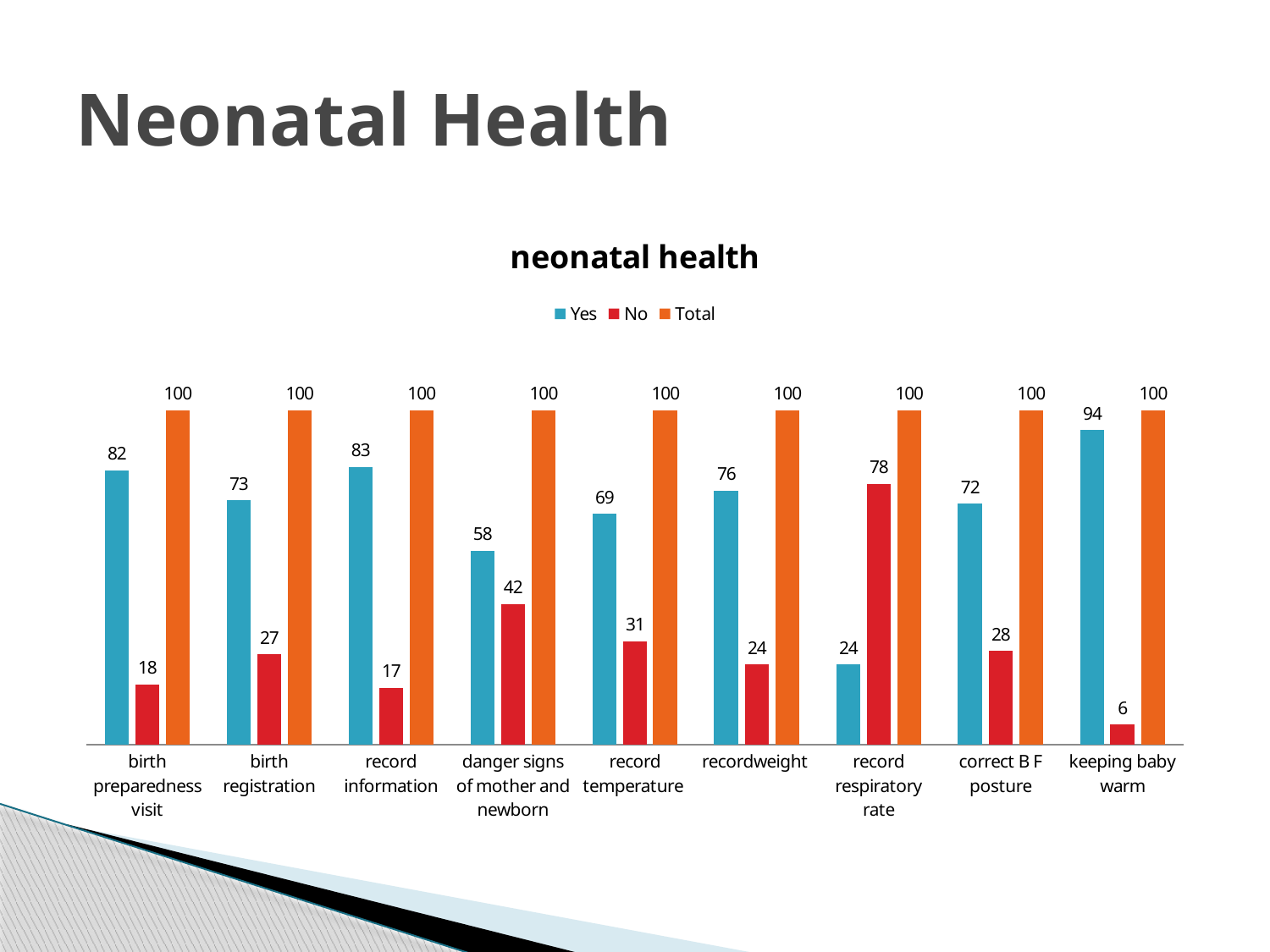
Is the Yes value for record information larger than the Yes value for birth registration? Yes What is the Yes value for birth preparedness visit? 82 What kind of chart is shown? bar chart How many series does the legend list? 3 How many categories are shown on the x axis? 9 What is the title of the chart? neonatal health Which category has the highest Yes value? keeping baby warm Which category has the lowest No value? keeping baby warm What is the Yes value for keeping baby warm? 94 What is the difference between the Yes and No values for record temperature? 38 What is the No value for danger signs of mother and newborn? 42 Which category has the highest No value? record respiratory rate